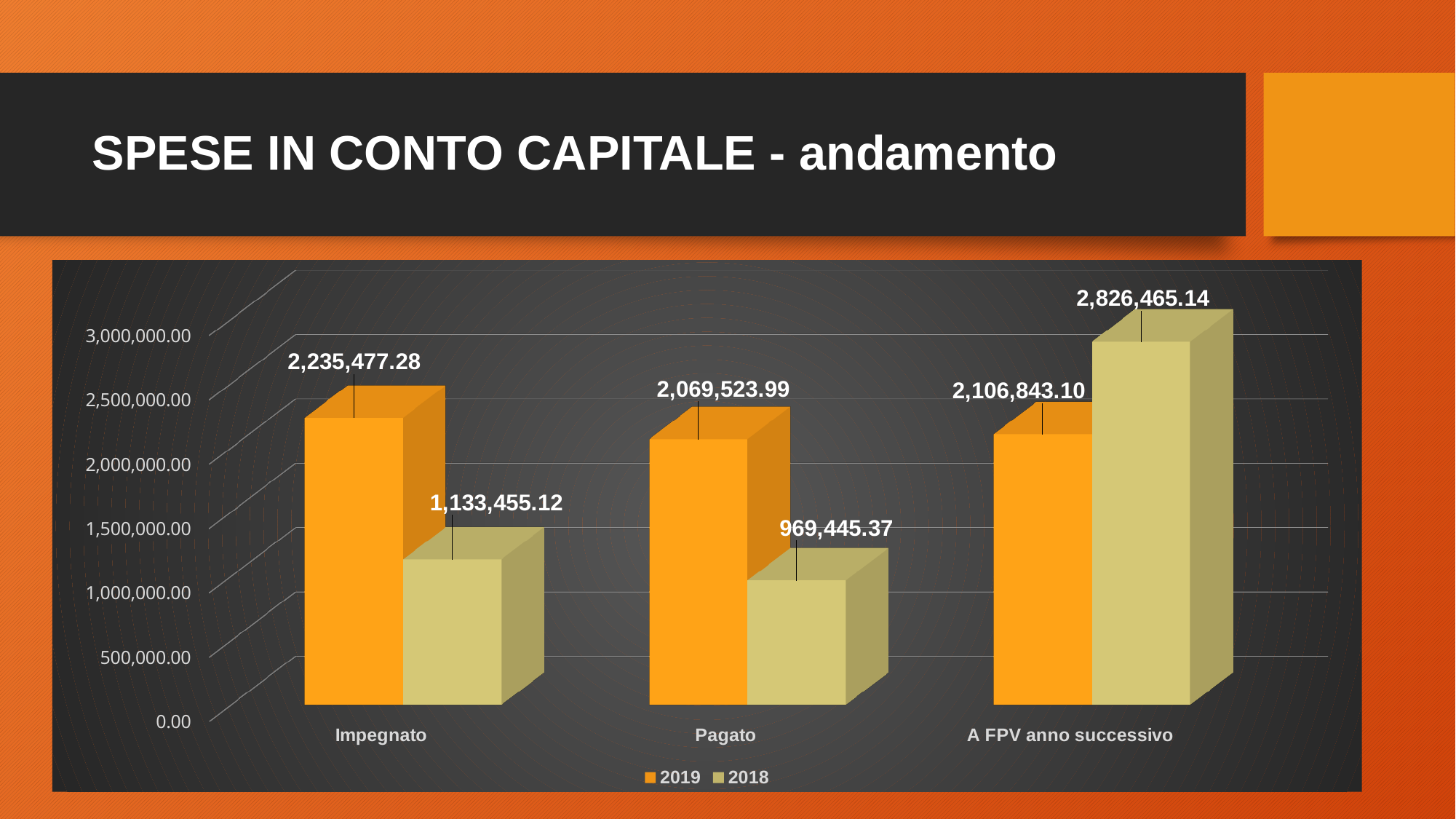
For A FPV anno successivo, which series has the larger value, 2019 or 2018? 2018 What is the 2018 value for A FPV anno successivo? 2,826,465.14 What is the 2018 value for Pagato? 969,445.37 What is the 2019 value for A FPV anno successivo? 2,106,843.10 Which category has the lowest 2018 value? Pagato Is the 2019 value for Pagato greater or less than 2,000,000.00? greater What is the 2019 value for Impegnato? 2,235,477.28 Which category has the highest 2019 value? Impegnato What is the difference between the 2019 and 2018 values for Impegnato? 1,102,022.16 Which category has the highest 2018 value? A FPV anno successivo How many series does the legend list? 2 How many categories are shown on the x axis? 3